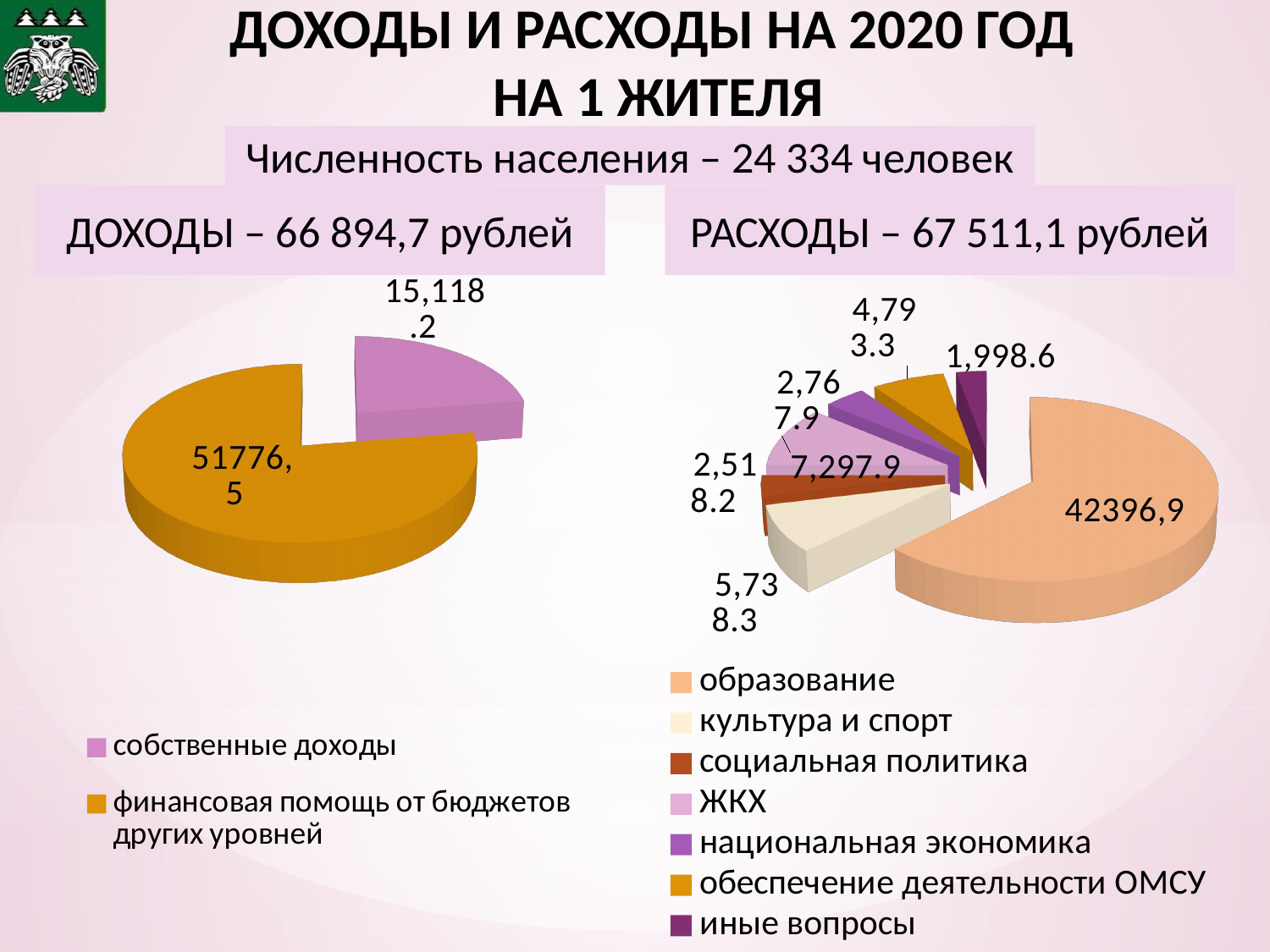
In the РАСХОДЫ pie chart, which category has the smallest slice? иные вопросы In the РАСХОДЫ pie chart, what is the value for образование? 42396,9 What kind of chart is used for ДОХОДЫ on the left of the slide? Pie chart How many entries does the legend of the РАСХОДЫ pie chart list? 7 In the РАСХОДЫ pie chart, what is the value for ЖКХ? 7,297.9 In the РАСХОДЫ pie chart, which is larger: культура и спорт or социальная политика? культура и спорт In the ДОХОДЫ pie chart, what is the value for собственные доходы? 15,118.2 In the ДОХОДЫ pie chart, what is the value for финансовая помощь от бюджетов других уровней? 51776,5 What colour is the образование slice in the РАСХОДЫ pie chart? Light orange (peach) In the РАСХОДЫ pie chart, what is the difference between ЖКХ and культура и спорт? 1,559.6 In the ДОХОДЫ pie chart, which category has the larger slice? финансовая помощь от бюджетов других уровней How many slices does the РАСХОДЫ pie chart have? 7